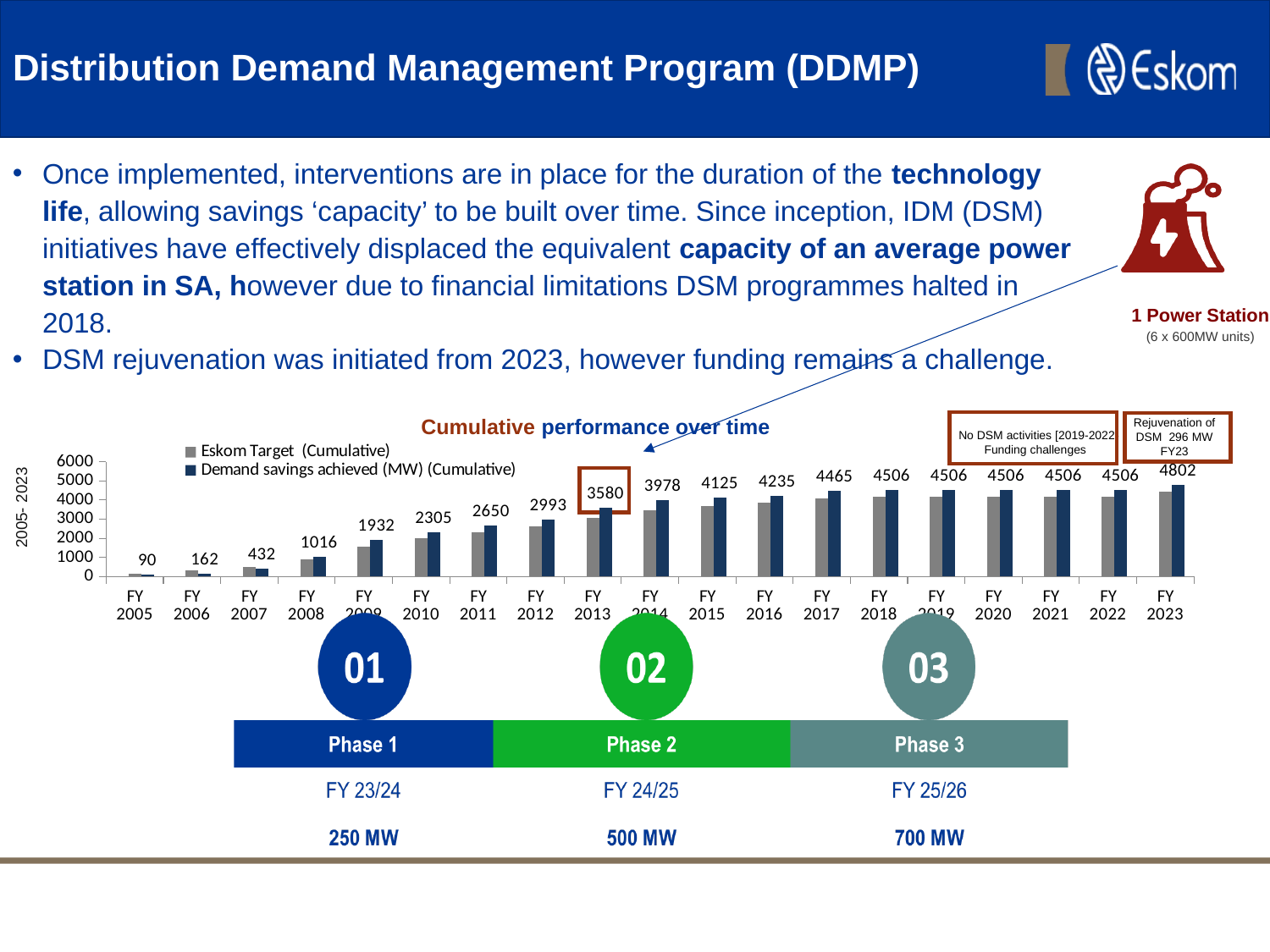
Which fiscal year has the lowest labelled value in the 'Cumulative performance over time' chart? FY 2005 What value is labelled above the bars for FY 2008 in the 'Cumulative performance over time' chart? 1016 Which has the larger labelled value in the 'Cumulative performance over time' chart, FY 2012 or FY 2014? FY 2014 What is the title of the bar chart on the slide? Cumulative performance over time By how much does the labelled value for FY 2023 exceed the labelled value for FY 2022 in the 'Cumulative performance over time' chart? 296 What value is labelled above the bars for FY 2023 in the 'Cumulative performance over time' chart? 4802 What kind of chart is the 'Cumulative performance over time' chart? bar chart How many fiscal years are shown on the x axis of the 'Cumulative performance over time' chart? 19 Do the labelled values in the 'Cumulative performance over time' chart generally rise or fall from FY 2005 to FY 2023? rise What value is labelled above the bars for FY 2013 in the 'Cumulative performance over time' chart? 3580 Which fiscal year has the highest labelled value in the 'Cumulative performance over time' chart? FY 2023 How many series does the legend of the 'Cumulative performance over time' chart list? 2